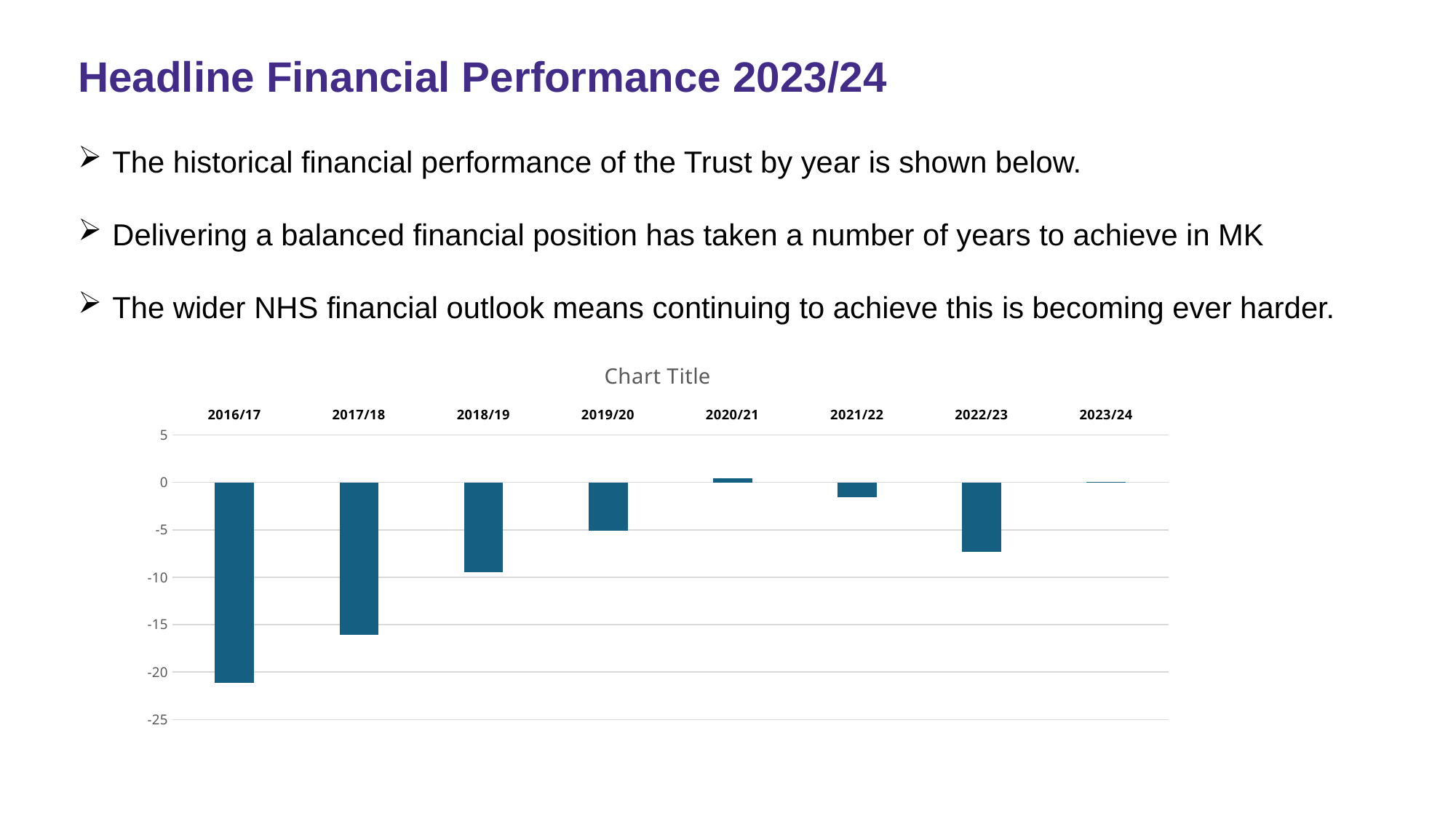
Which year has the lowest value on the chart? 2016/17 Is the value for 2021/22 greater or less than -5? greater Is the value for 2018/19 greater or less than -5? less Is the value for 2016/17 greater or less than -20? less Which is larger, the value for 2016/17 or the value for 2017/18? 2017/18 What is the title shown above the chart? Chart Title How many years (categories) are plotted on the chart? 8 Do the values generally rise or fall from 2016/17 to 2020/21? rise What kind of chart is shown on the slide? bar chart Which is larger, the value for 2018/19 or the value for 2022/23? 2022/23